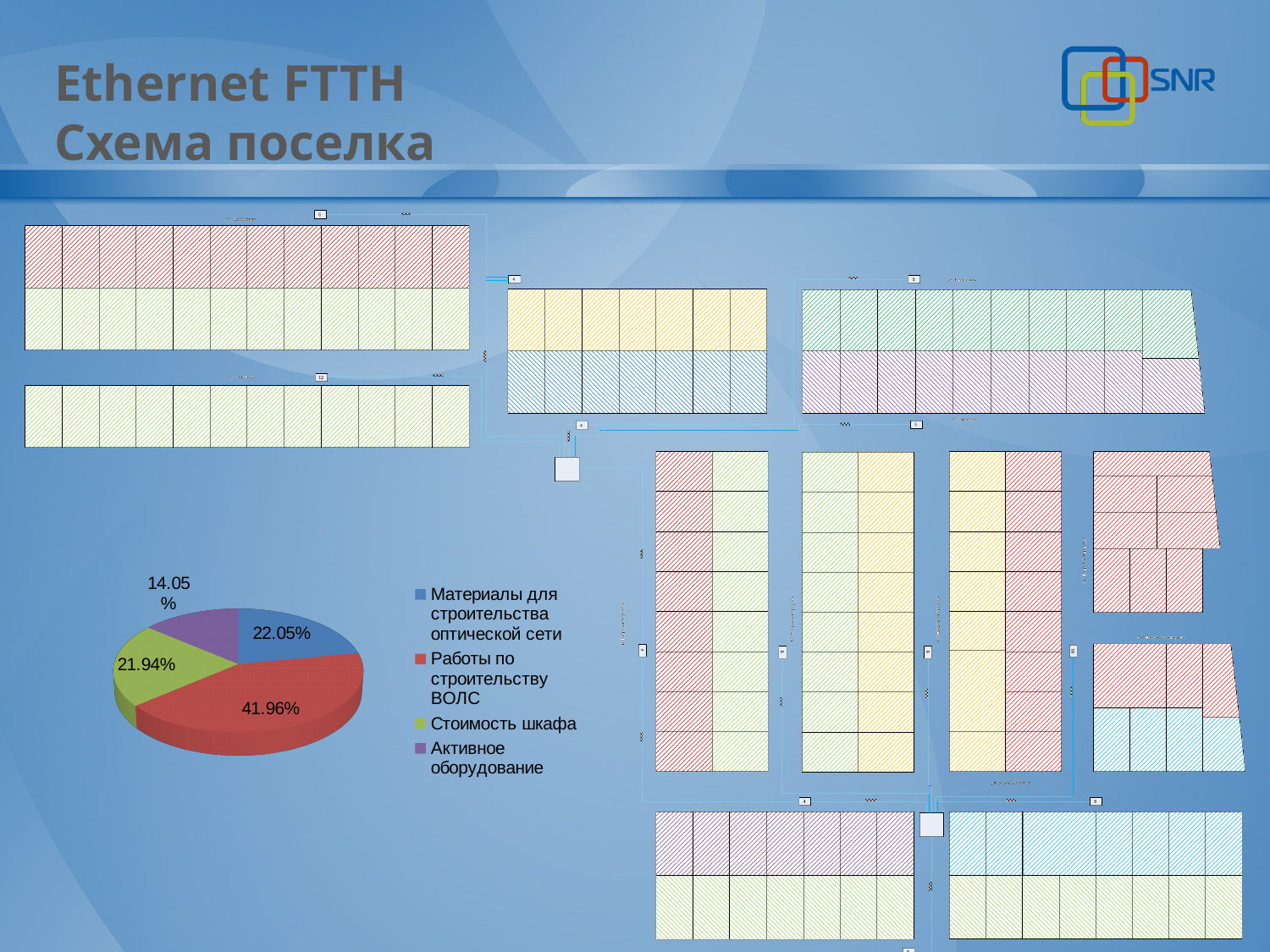
How many entries does the legend of the pie chart list? 4 What share of the pie does "Активное оборудование" have? 14.05% Which is larger: the share of "Работы по строительству ВОЛС" or the share of "Стоимость шкафа"? Работы по строительству ВОЛС What colour is the slice for "Стоимость шкафа" in the pie chart? green Which category has the largest slice of the pie? Работы по строительству ВОЛС What share of the pie does "Стоимость шкафа" have? 21.94% What is the difference between the shares of "Работы по строительству ВОЛС" and "Активное оборудование"? 27.91% Which category has the smallest slice of the pie? Активное оборудование What share of the pie does "Материалы для строительства оптической сети" have? 22.05% How many slices does the pie chart have? 4 What kind of chart is shown on the slide? pie chart